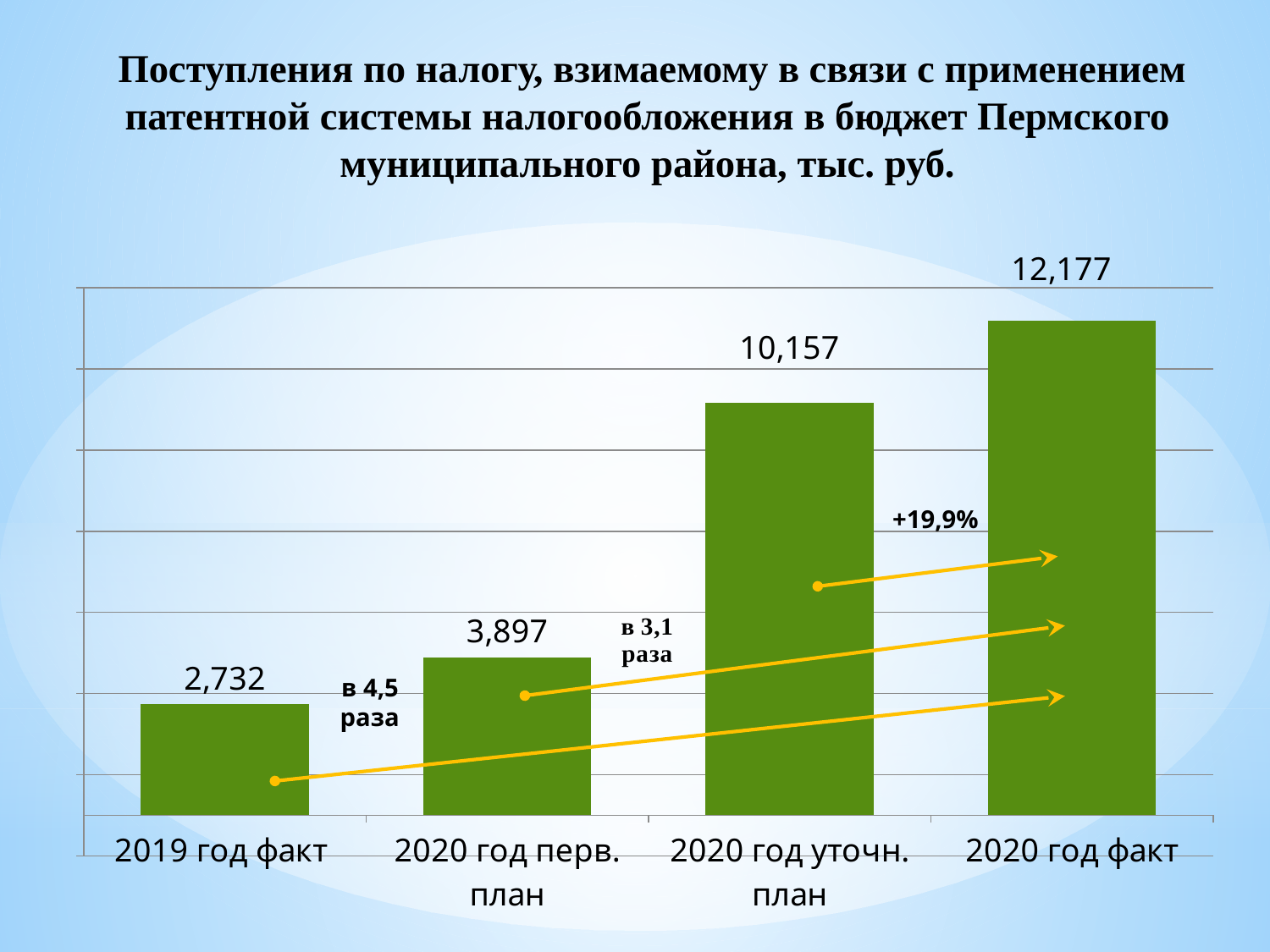
Which is larger, the value for 2020 год уточн. план or the value for 2020 год перв. план? 2020 год уточн. план What is the value for 2020 год перв. план? 3,897 How many categories are shown on the x axis? 4 What is the value for 2019 год факт? 2,732 What is the difference between the values for 2020 год перв. план and 2019 год факт? 1,165 What is the difference between the values for 2020 год факт and 2020 год уточн. план? 2,020 Which category has the lowest value? 2019 год факт What kind of chart is shown on the slide? bar chart What is the value for 2020 год факт? 12,177 What is the value for 2020 год уточн. план? 10,157 Which category has the highest value? 2020 год факт Do the values rise or fall from left to right along the x axis? rise